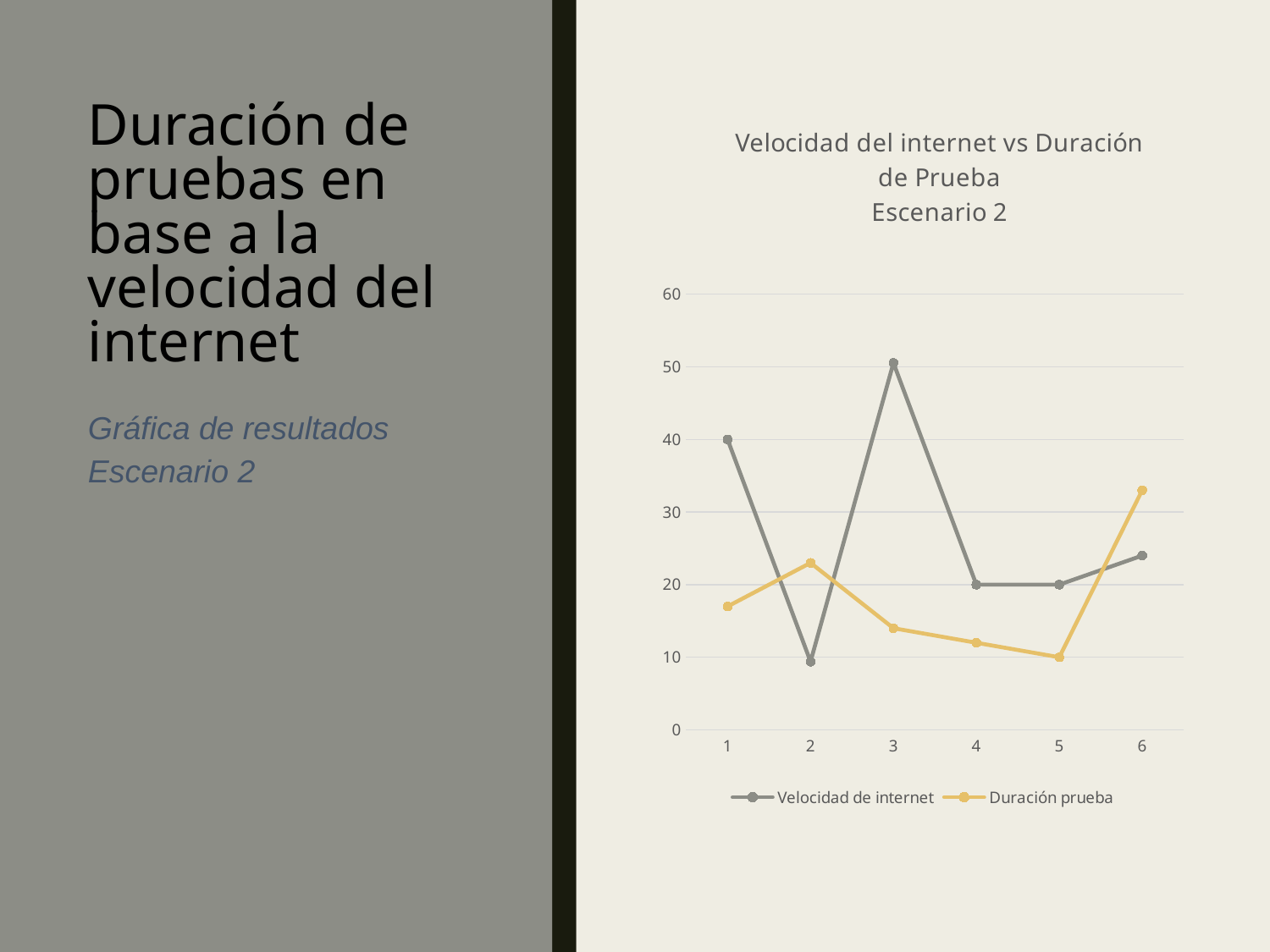
Is the value of Velocidad de internet at point 3 greater or less than 40? greater What kind of chart is shown on the slide? line chart At point 2, which series has the higher value, Velocidad de internet or Duración prueba? Duración prueba At which x-axis point does the Duración prueba series reach its highest value? 6 At which x-axis point does the Velocidad de internet series reach its highest value? 3 How many series does the legend list? 2 Is the value of Duración prueba at point 6 greater or less than 30? greater At which x-axis point does the Velocidad de internet series reach its lowest value? 2 At point 1, which series has the higher value, Velocidad de internet or Duración prueba? Velocidad de internet How many points are plotted along the x axis for each series? 6 Does the Duración prueba series rise or fall from point 2 to point 5? fall Is the value of Duración prueba at point 5 greater or less than 20? less